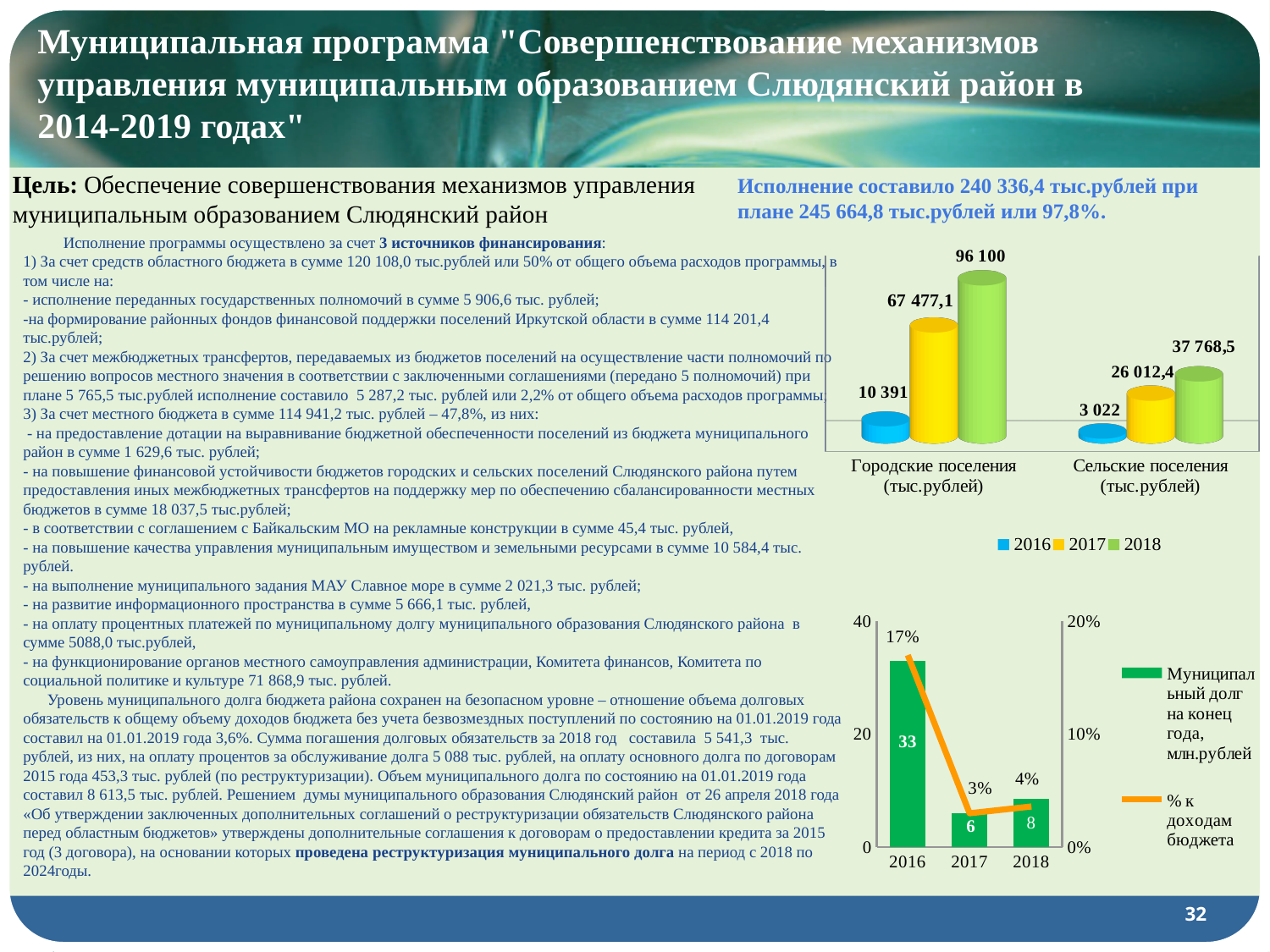
In the top chart on the right, which year has the lowest value for Сельские поселения? 2016 In the top chart on the right, what is the 2016 value for Городские поселения? 10 391 In the top chart on the right, is the 2018 value for Городские поселения larger or smaller than the 2018 value for Сельские поселения? larger In the bottom chart, which year has the lowest municipal debt? 2017 In the bottom chart, what is the value of '% к доходам бюджета' for 2018? 4% In the bottom chart, how many years are shown on the x axis? 3 In the bottom chart, what is the municipal debt at the end of 2016, in млн.рублей? 33 In the top chart on the right, do the values for Городские поселения rise or fall from 2016 to 2018? rise In the top chart on the right, what is the 2017 value for Сельские поселения? 26 012,4 In the top chart on the right, how many series does the legend list? 3 In the top chart on the right, what is the 2018 value for Городские поселения? 96 100 In the bottom chart, what is the difference between the municipal debt in 2016 and in 2017? 27